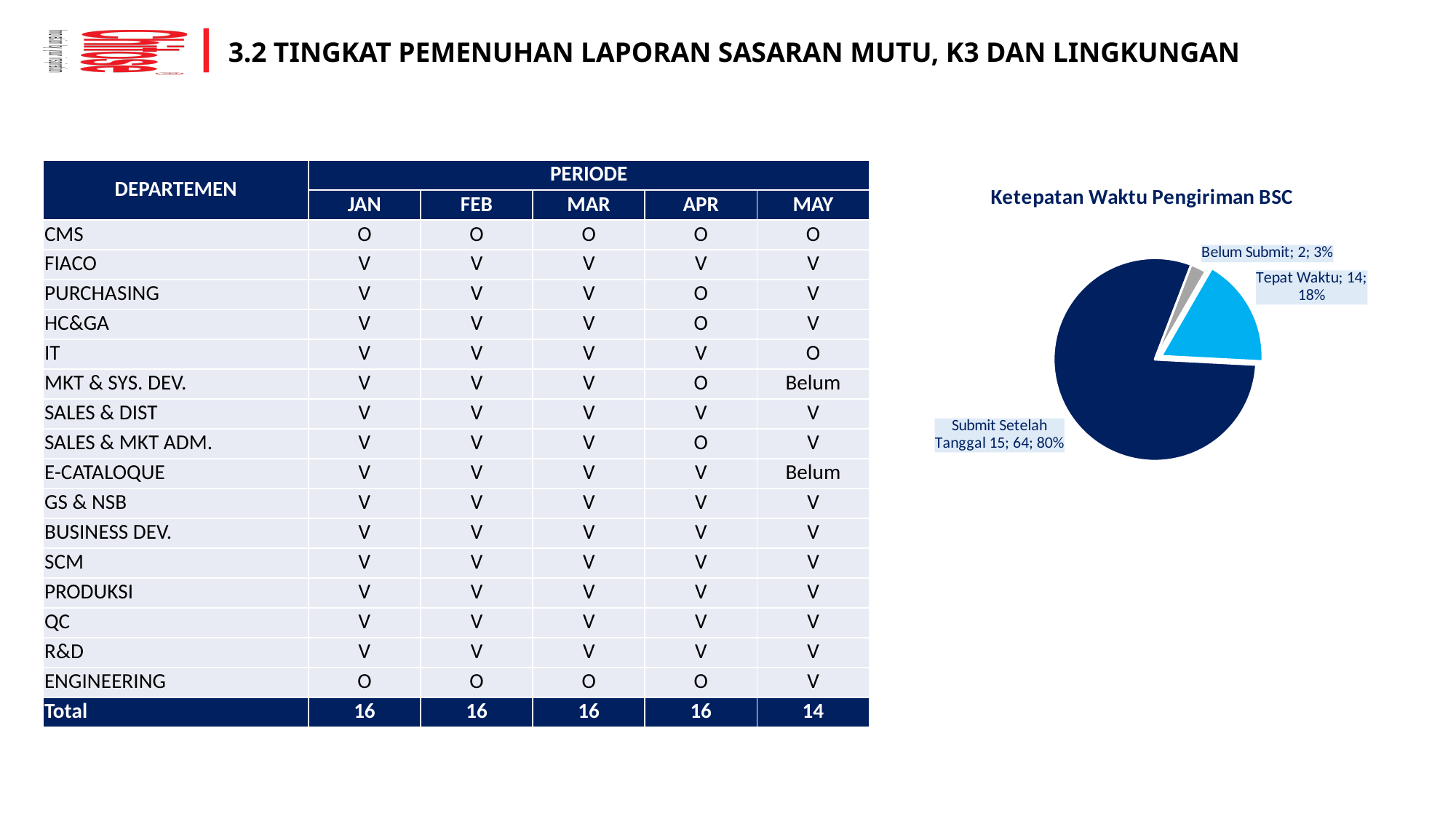
What is the difference between the values for Submit Setelah Tanggal 15 and Tepat Waktu in the pie chart? 50 What is the title of the pie chart? Ketepatan Waktu Pengiriman BSC What is the value for Belum Submit in the pie chart? 2 What is the value for Tepat Waktu in the pie chart? 14 What is the value for Submit Setelah Tanggal 15 in the pie chart? 64 Which slice of the pie chart is the smallest? Belum Submit Which slice of the pie chart is the largest? Submit Setelah Tanggal 15 What type of chart is shown on the slide? Pie chart What share of the pie does Belum Submit represent? 3% How many slices does the pie chart have? 3 What share of the pie does Tepat Waktu represent? 18% What share of the pie does Submit Setelah Tanggal 15 represent? 80%